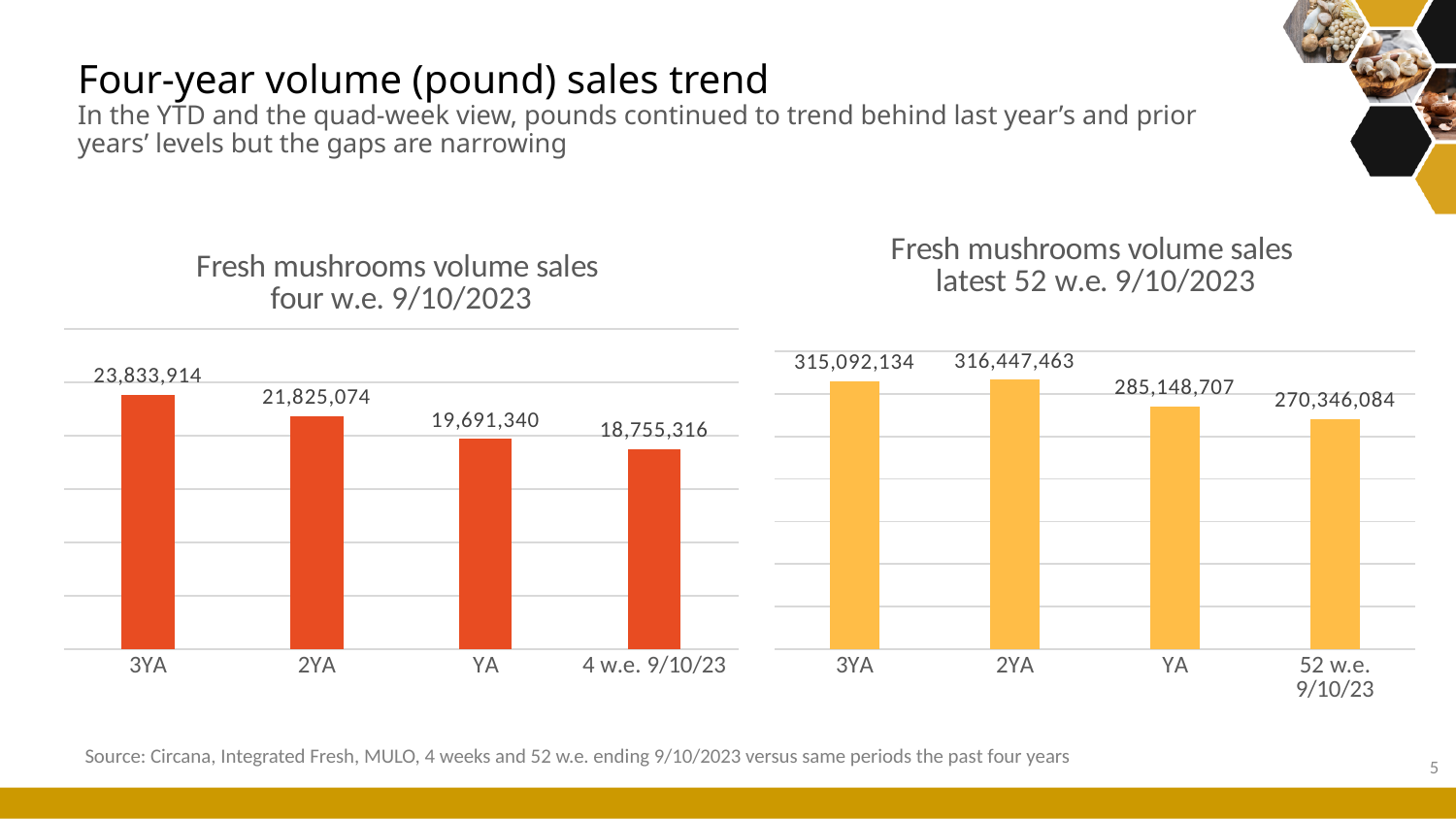
In the 'Fresh mushrooms volume sales four w.e. 9/10/2023' chart, what is the difference between the 3YA value and the 4 w.e. 9/10/23 value? 5,078,598 In the 'Fresh mushrooms volume sales four w.e. 9/10/2023' chart, what is the value for 3YA? 23,833,914 In the 'Fresh mushrooms volume sales latest 52 w.e. 9/10/2023' chart, what is the difference between the YA value and the 52 w.e. 9/10/23 value? 14,802,623 What kind of chart is the 'Fresh mushrooms volume sales latest 52 w.e. 9/10/2023' chart? Bar chart In the 'Fresh mushrooms volume sales four w.e. 9/10/2023' chart, which category has the highest value? 3YA In the 'Fresh mushrooms volume sales four w.e. 9/10/2023' chart, do the values rise or fall from 3YA to 4 w.e. 9/10/23? Fall In the 'Fresh mushrooms volume sales latest 52 w.e. 9/10/2023' chart, which category has the lowest value? 52 w.e. 9/10/23 In the 'Fresh mushrooms volume sales latest 52 w.e. 9/10/2023' chart, which is larger, the value for 3YA or the value for 2YA? 2YA In the 'Fresh mushrooms volume sales latest 52 w.e. 9/10/2023' chart, what is the value for 52 w.e. 9/10/23? 270,346,084 In the 'Fresh mushrooms volume sales latest 52 w.e. 9/10/2023' chart, what is the value for YA? 285,148,707 How many categories are shown in the 'Fresh mushrooms volume sales four w.e. 9/10/2023' chart? 4 In the 'Fresh mushrooms volume sales four w.e. 9/10/2023' chart, what is the value for 4 w.e. 9/10/23? 18,755,316